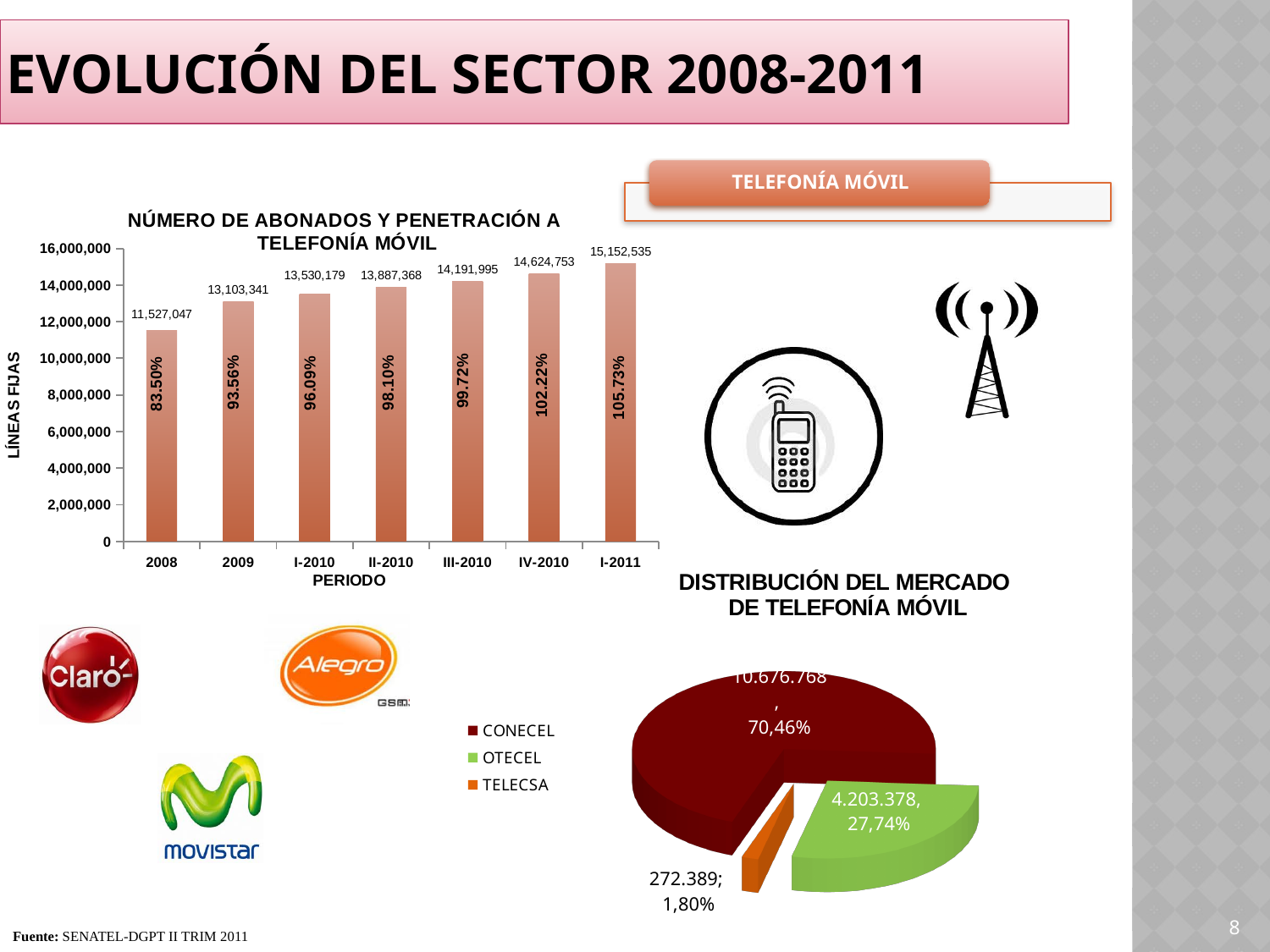
In the chart 'NÚMERO DE ABONADOS Y PENETRACIÓN A TELEFONÍA MÓVIL', what is the number of subscribers for 2008? 11,527,047 In the chart 'DISTRIBUCIÓN DEL MERCADO DE TELEFONÍA MÓVIL', which operator has the smallest slice? TELECSA In the chart 'NÚMERO DE ABONADOS Y PENETRACIÓN A TELEFONÍA MÓVIL', how many periods are shown on the x axis? 7 In the chart 'NÚMERO DE ABONADOS Y PENETRACIÓN A TELEFONÍA MÓVIL', what penetration percentage is shown for IV-2010? 102.22% In the chart 'DISTRIBUCIÓN DEL MERCADO DE TELEFONÍA MÓVIL', what share of the market does OTECEL hold? 27,74% What kind of chart is 'NÚMERO DE ABONADOS Y PENETRACIÓN A TELEFONÍA MÓVIL'? bar chart In the chart 'NÚMERO DE ABONADOS Y PENETRACIÓN A TELEFONÍA MÓVIL', which period has the highest number of subscribers? I-2011 In the chart 'NÚMERO DE ABONADOS Y PENETRACIÓN A TELEFONÍA MÓVIL', which period has the lowest number of subscribers? 2008 In the chart 'NÚMERO DE ABONADOS Y PENETRACIÓN A TELEFONÍA MÓVIL', what is the number of subscribers for I-2011? 15,152,535 In the chart 'NÚMERO DE ABONADOS Y PENETRACIÓN A TELEFONÍA MÓVIL', do the subscriber numbers rise or fall from 2008 to I-2011? rise In the chart 'NÚMERO DE ABONADOS Y PENETRACIÓN A TELEFONÍA MÓVIL', what is the difference in subscribers between I-2011 and 2008? 3,625,488 How many entries does the legend of the chart 'DISTRIBUCIÓN DEL MERCADO DE TELEFONÍA MÓVIL' list? 3